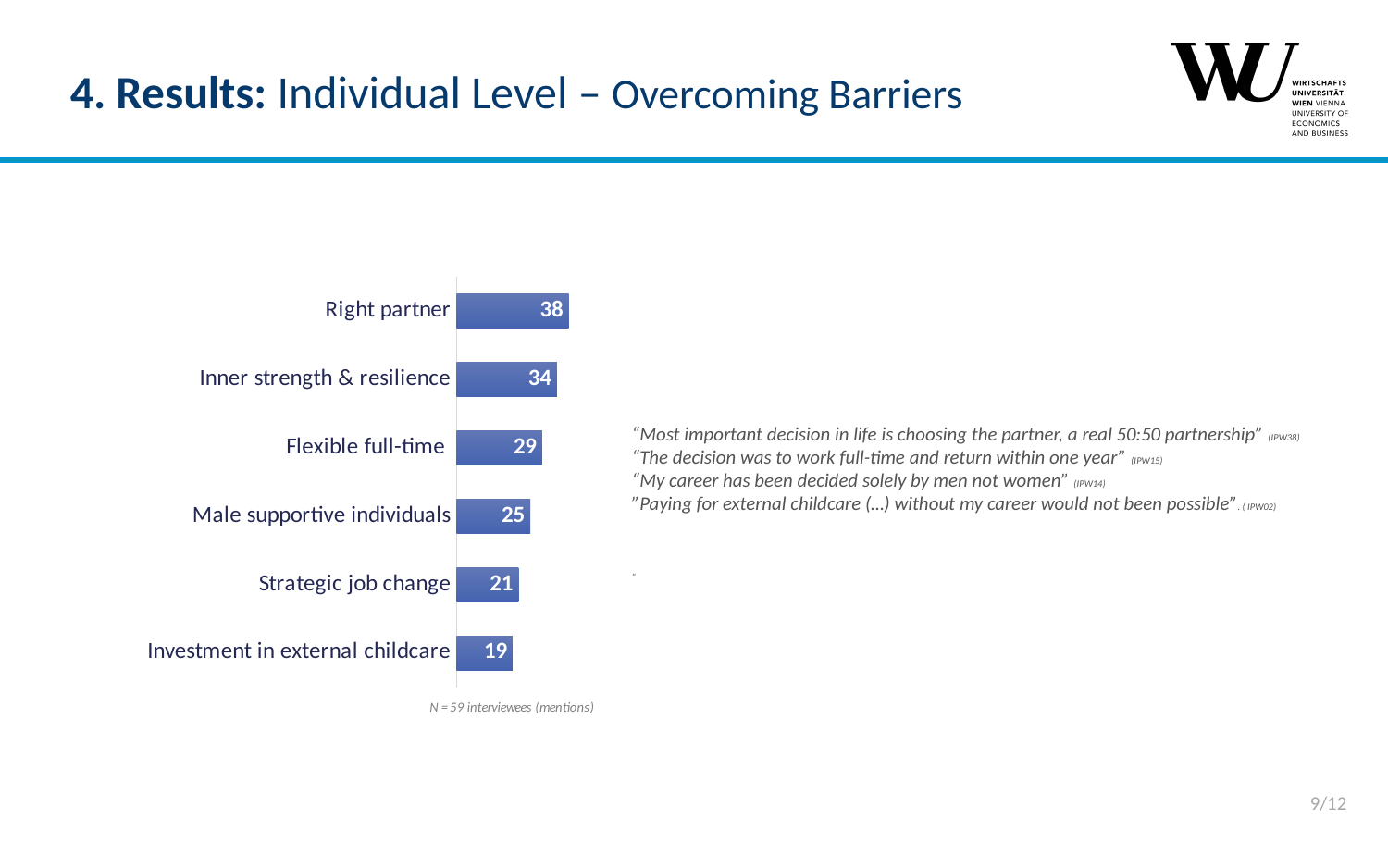
What is the value for Investment in external childcare? 19 What kind of chart is shown on the slide? Bar chart What is the value for Flexible full-time? 29 How many categories are shown in the chart? 6 Which category has the highest value? Right partner What is the value for Strategic job change? 21 Which category has the lowest value? Investment in external childcare What does the note below the chart say the sample size is? N = 59 interviewees (mentions) What is the difference between the values for Male supportive individuals and Strategic job change? 4 Which is larger, the value for Flexible full-time or the value for Male supportive individuals? Flexible full-time What is the difference between the values for Right partner and Inner strength & resilience? 4 What is the value for Right partner? 38